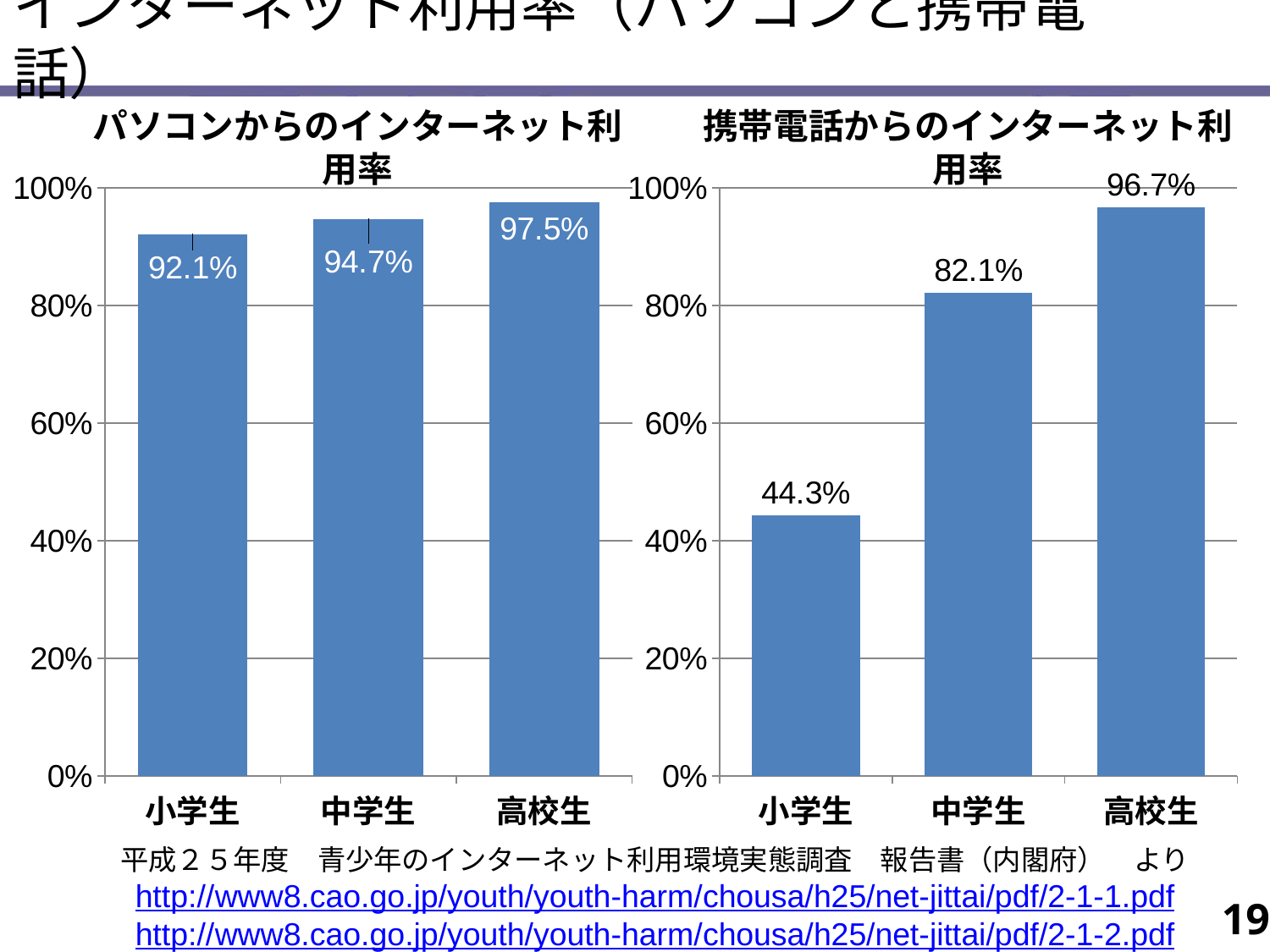
In the left chart (パソコンからのインターネット利用率), which category has the highest value? 高校生 In the left chart (パソコンからのインターネット利用率), what is the value for 高校生? 97.5% In the left chart (パソコンからのインターネット利用率), what is the difference between the values for 中学生 and 小学生? 2.6% In the left chart (パソコンからのインターネット利用率), what is the value for 小学生? 92.1% How many categories are shown in the left chart (パソコンからのインターネット利用率)? 3 Which is larger: the value for 中学生 in the left chart (パソコン) or the value for 中学生 in the right chart (携帯電話)? 中学生 in the left chart (パソコン), 94.7% In the right chart (携帯電話からのインターネット利用率), do the values rise or fall from 小学生 to 高校生? rise In the right chart (携帯電話からのインターネット利用率), what is the difference between the values for 高校生 and 小学生? 52.4% What kind of chart is the right chart (携帯電話からのインターネット利用率)? bar chart In the right chart (携帯電話からのインターネット利用率), which category has the lowest value? 小学生 In the right chart (携帯電話からのインターネット利用率), what is the value for 中学生? 82.1% In the right chart (携帯電話からのインターネット利用率), what is the value for 小学生? 44.3%